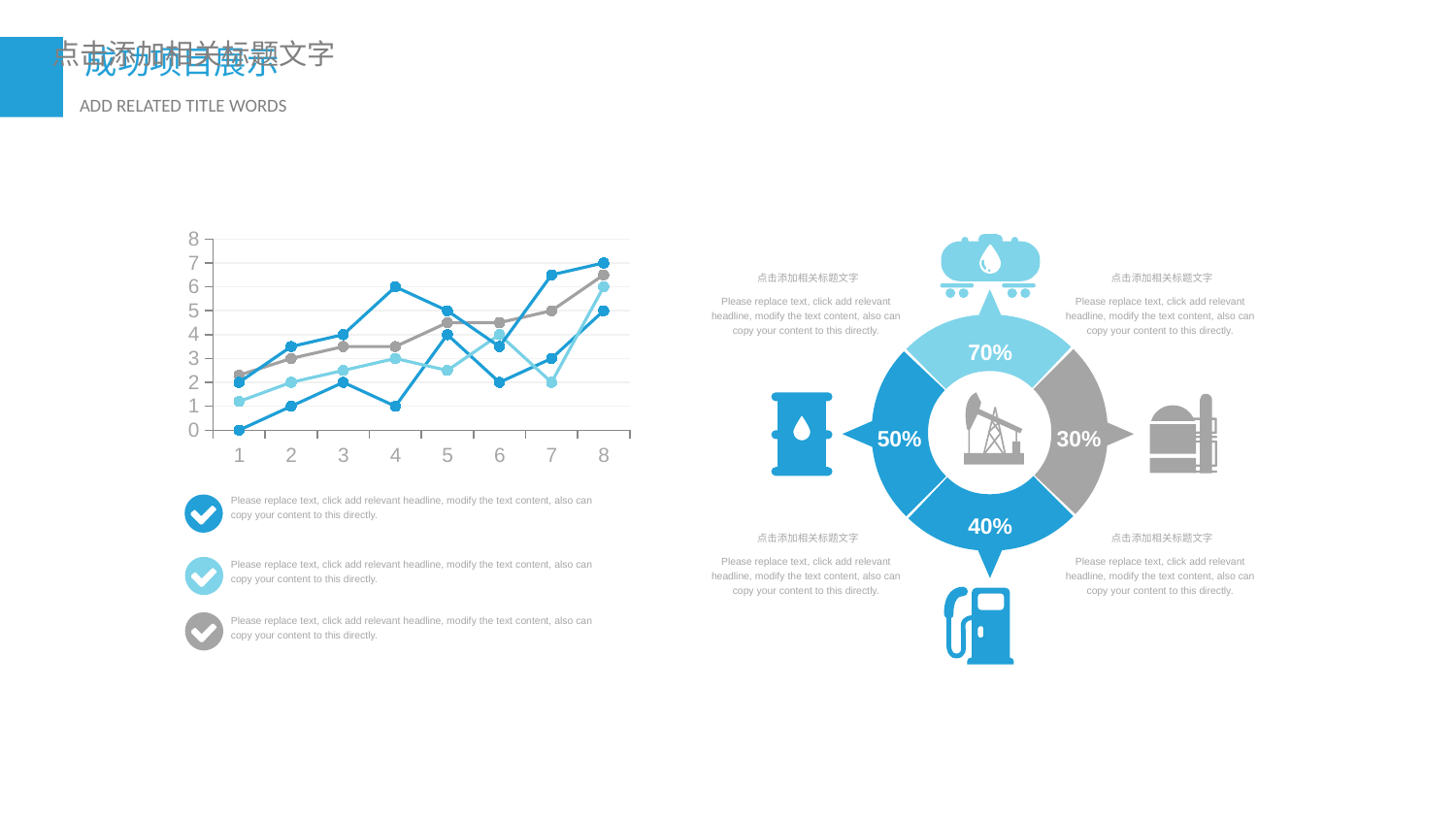
How many points are labelled along the x axis of the line chart on the left? 8 In the line chart on the left, what is the highest value plotted at x = 8? 7 In the line chart on the left, what is the highest value plotted at x = 4? 6 In the ring diagram on the right, which segment shows the lowest percentage? the right segment (30%) In the line chart on the left, what is the lowest value plotted at x = 1? 0 What type of chart is shown on the left of the slide? line chart In the line chart on the left, is the highest value at x = 7 greater or less than 6? greater How many lines are plotted in the line chart on the left? 4 In the line chart on the left, does the gray line generally rise or fall from x = 1 to x = 8? rise In the ring diagram on the right, what percentage is shown in the top segment? 70% In the line chart on the left, what is the maximum value shown on the y axis? 8 In the ring diagram on the right, what is the difference between the top segment's percentage and the right segment's percentage? 40%